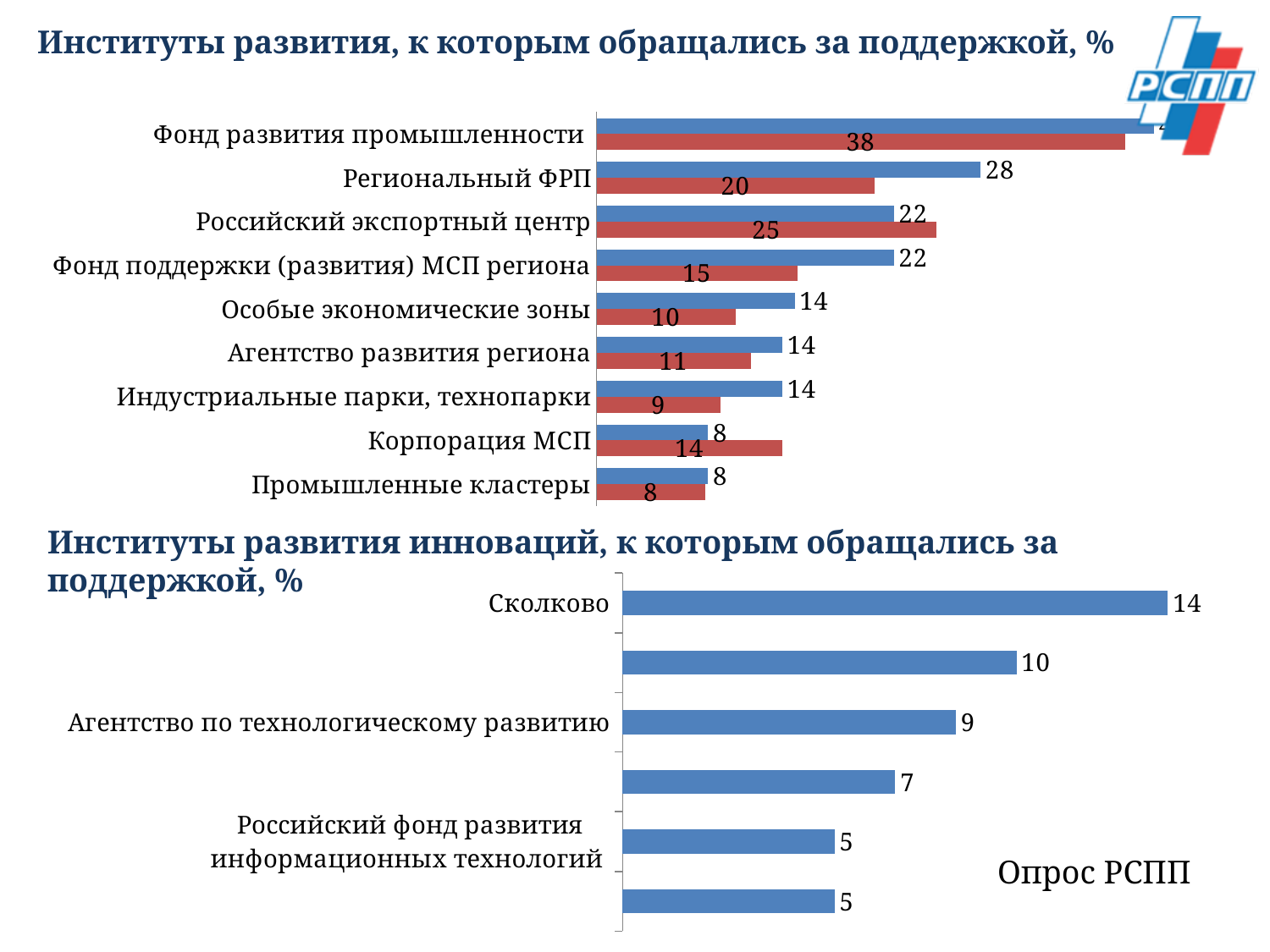
In the bottom chart, what is the value for Агентство по технологическому развитию? 9 In the bottom chart, what is the value for Сколково? 14 In the top chart, what is the value of the red bar for Российский экспортный центр? 25 In the bottom chart, which category has the highest value? Сколково What type of chart is the bottom chart? bar chart In the top chart, what is the value of the blue bar for Корпорация МСП? 8 In the top chart, what is the difference between the blue and red bars for Региональный ФРП? 8 In the top chart, how many categories are listed? 9 In the top chart, which category has the lowest red bar value? Промышленные кластеры In the top chart, for Корпорация МСП, which bar is larger, the blue or the red? red In the top chart, what is the value of the red bar for Фонд развития промышленности? 38 In the top chart, what is the value of the blue bar for Региональный ФРП? 28